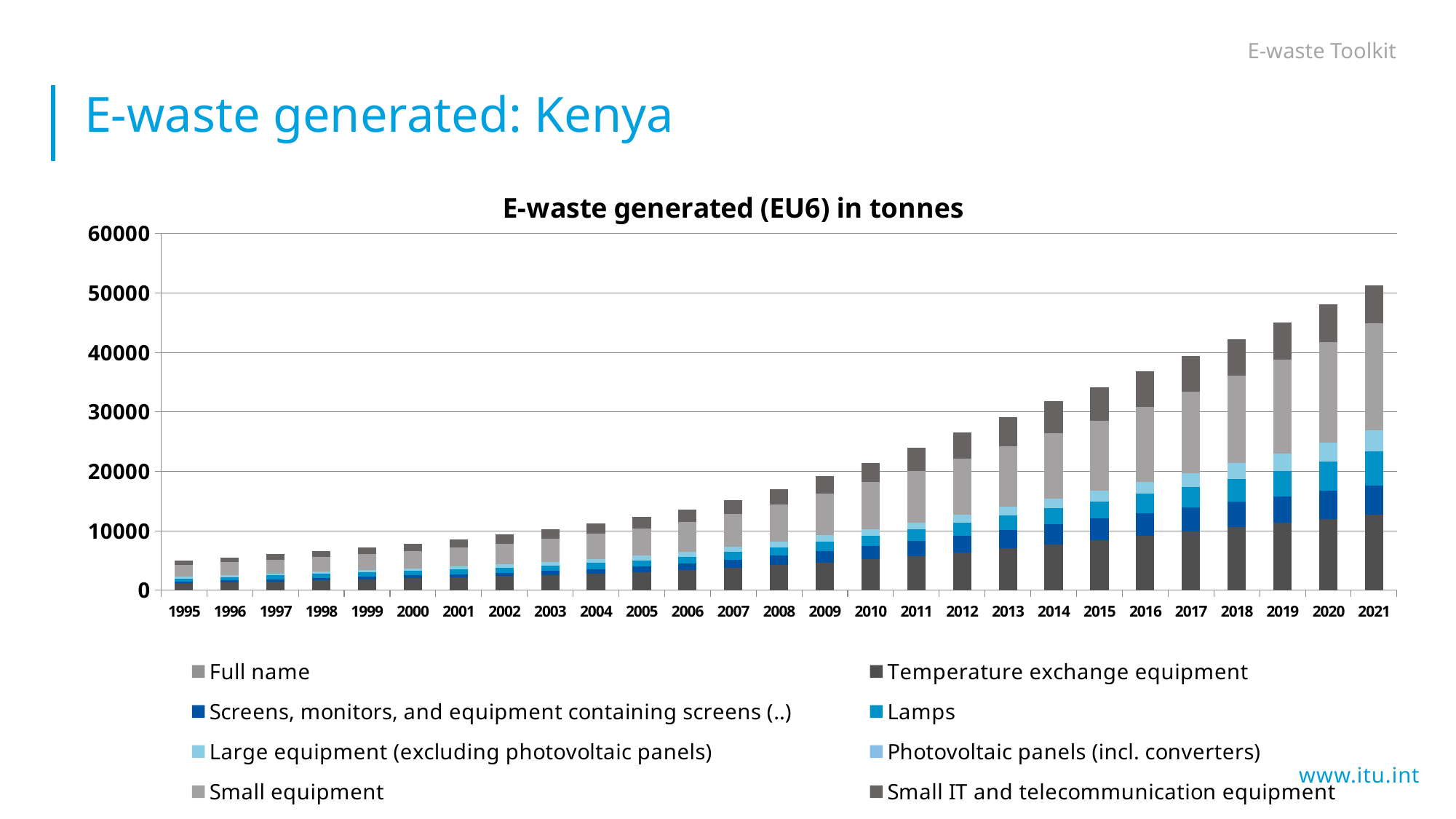
Is the total value for 2000 greater or less than 10000? less How many years are shown along the x axis of the chart? 27 Which year has the lowest total e-waste generated? 1995 What kind of chart is shown on the slide? Stacked bar chart Is the total value for 2021 greater or less than 40000? greater Which year has the highest total e-waste generated? 2021 Do the total values rise or fall from 1995 to 2021? Rise Is the total value for 2015 greater or less than 30000? greater How many series does the chart's legend list? 8 What is the title of the chart? E-waste generated (EU6) in tonnes Which year has the larger total e-waste generated, 2012 or 2018? 2018